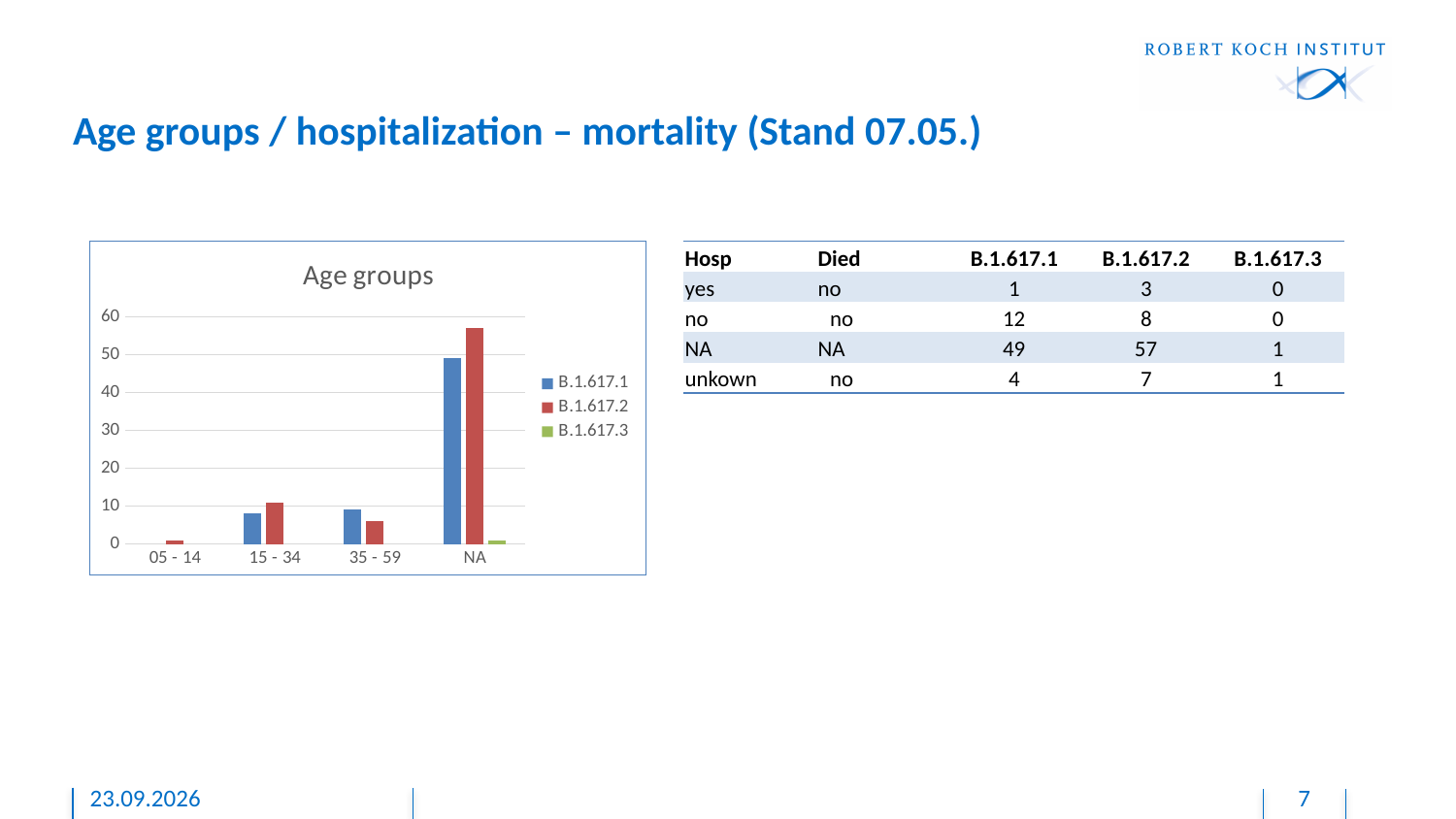
Which series is shown in red in the chart? B.1.617.2 Is the value for B.1.617.1 in the NA category greater or less than 40? greater How many series does the chart legend list? 3 What is the title of the chart? Age groups Which age group category has the highest value for B.1.617.2? NA Is the value for B.1.617.2 in the 35 - 59 category greater or less than 10? less In the NA category, which series has the larger value, B.1.617.1 or B.1.617.2? B.1.617.2 In the 35 - 59 category, which series has the larger value, B.1.617.1 or B.1.617.2? B.1.617.1 What kind of chart is shown on the slide? bar chart Is the value for B.1.617.2 in the NA category greater or less than 50? greater Which age group category has the highest value for B.1.617.1? NA How many age group categories are shown on the x axis of the chart? 4